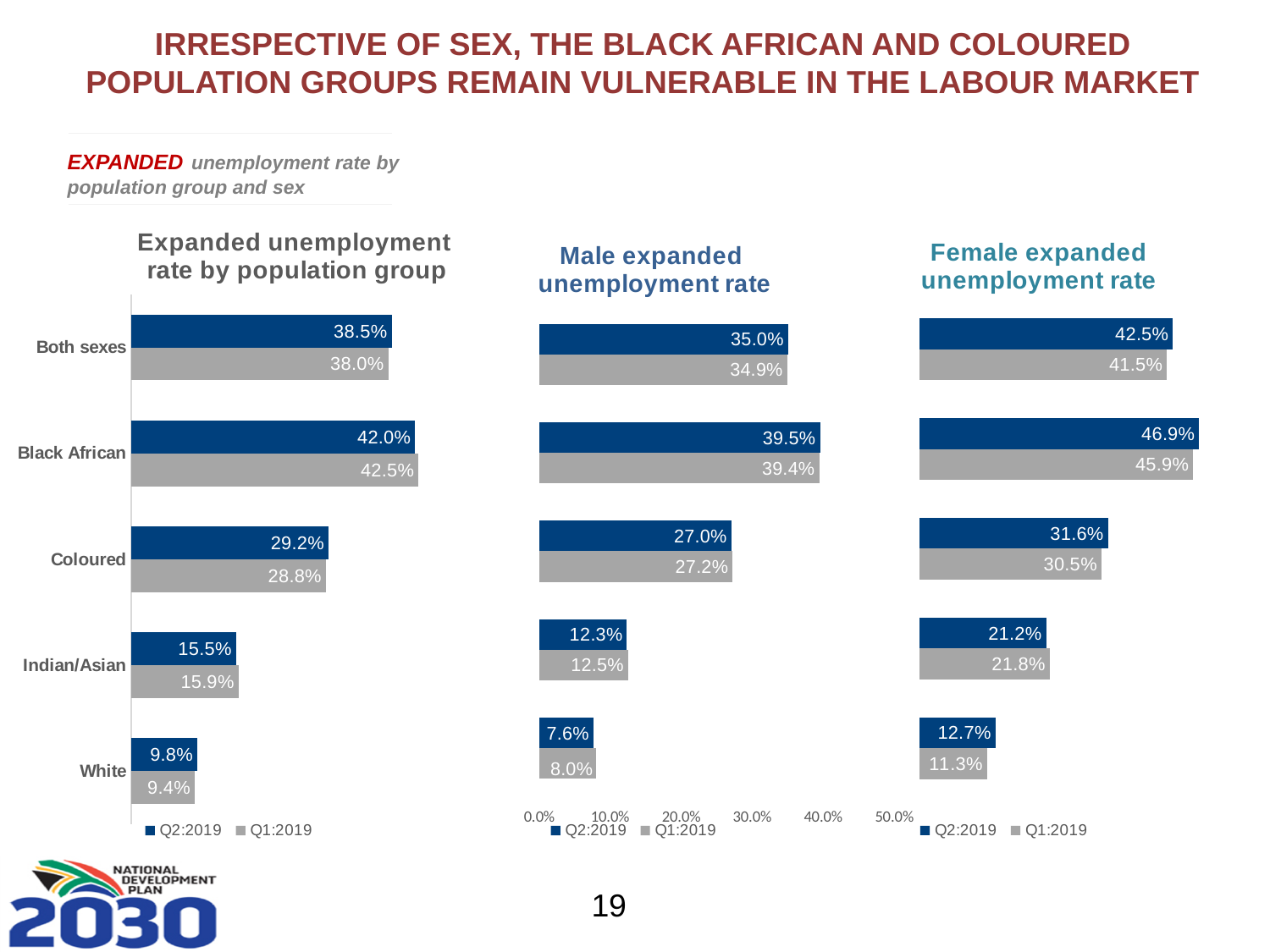
How many series does the legend of the 'Male expanded unemployment rate' chart list? 2 Is the Q2:2019 value for Black African in the 'Female expanded unemployment rate' chart greater or less than 40.0%? greater In the 'Male expanded unemployment rate' chart, what is the Q1:2019 value for White? 8.0% In the 'Female expanded unemployment rate' chart, what is the Q2:2019 value for Coloured? 31.6% In the 'Female expanded unemployment rate' chart, which population group has the highest Q2:2019 value? Black African In the 'Expanded unemployment rate by population group' chart, what is the difference between the Q2:2019 and Q1:2019 values for Coloured? 0.4% In the 'Male expanded unemployment rate' chart, which population group has the lowest Q2:2019 value? White How many population group categories are shown in the 'Expanded unemployment rate by population group' chart? 5 In the 'Male expanded unemployment rate' chart, which is larger for Indian/Asian: the Q2:2019 value or the Q1:2019 value? Q1:2019 What type of chart is the 'Female expanded unemployment rate' chart? Bar chart In the 'Female expanded unemployment rate' chart, what is the difference between the Q2:2019 and Q1:2019 values for White? 1.4% In the 'Expanded unemployment rate by population group' chart, what is the Q2:2019 value for Black African? 42.0%